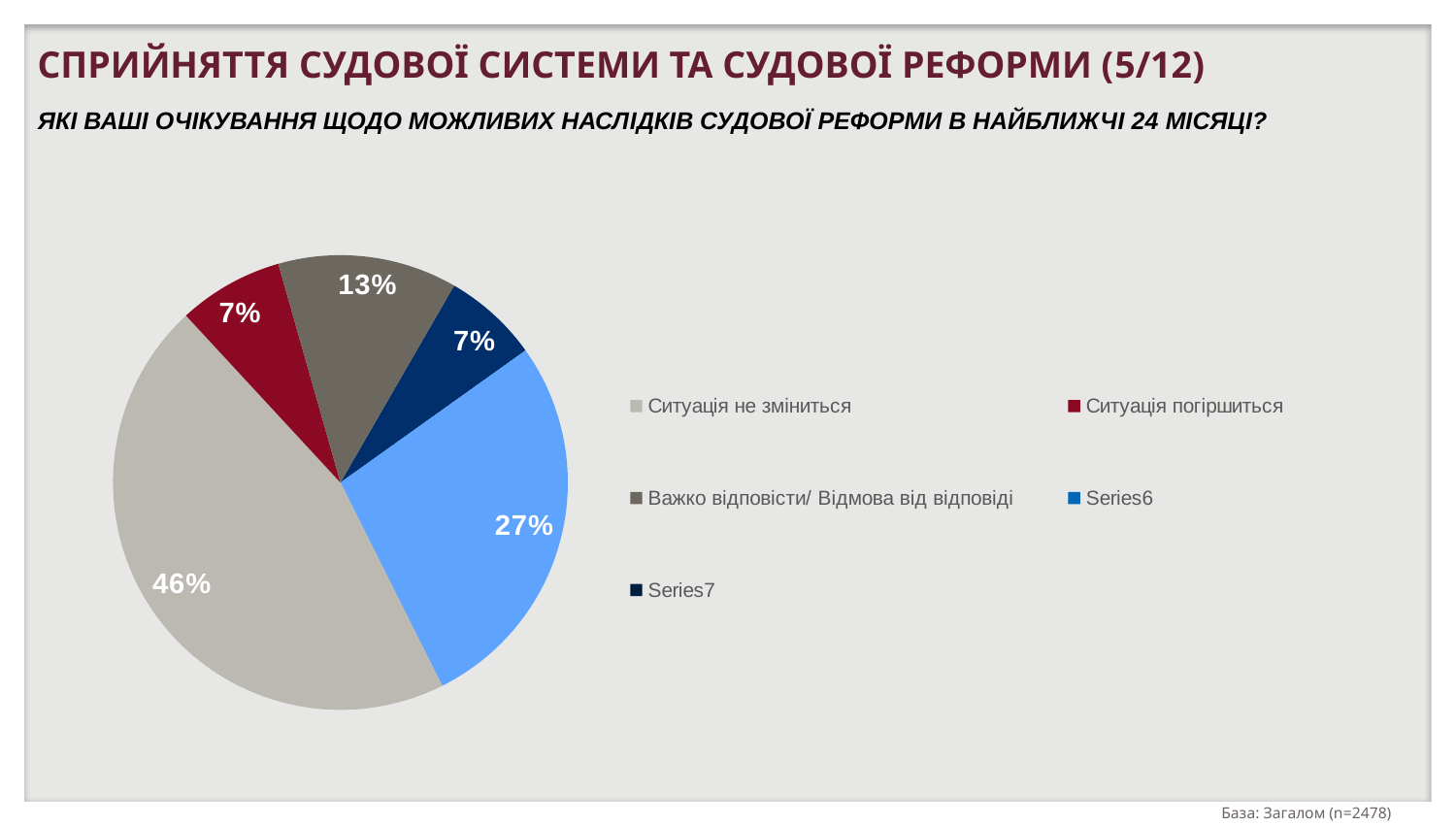
What share of the pie does Series6 have? 27% How many entries does the legend list? 5 What share of the pie does "Важко відповісти/ Відмова від відповіді" have? 13% How many slices does the pie chart have? 5 Which is larger: the share of "Важко відповісти/ Відмова від відповіді" or the share of "Ситуація погіршиться"? Важко відповісти/ Відмова від відповіді What share of the pie does Series7 have? 7% What colour is the slice for "Ситуація погіршиться"? dark red What is the difference between the shares of "Ситуація не зміниться" and Series6? 19% What kind of chart is shown on the slide? pie chart Which slice of the pie is the largest? Ситуація не зміниться What share of the pie does "Ситуація не зміниться" have? 46% What share of the pie does "Ситуація погіршиться" have? 7%